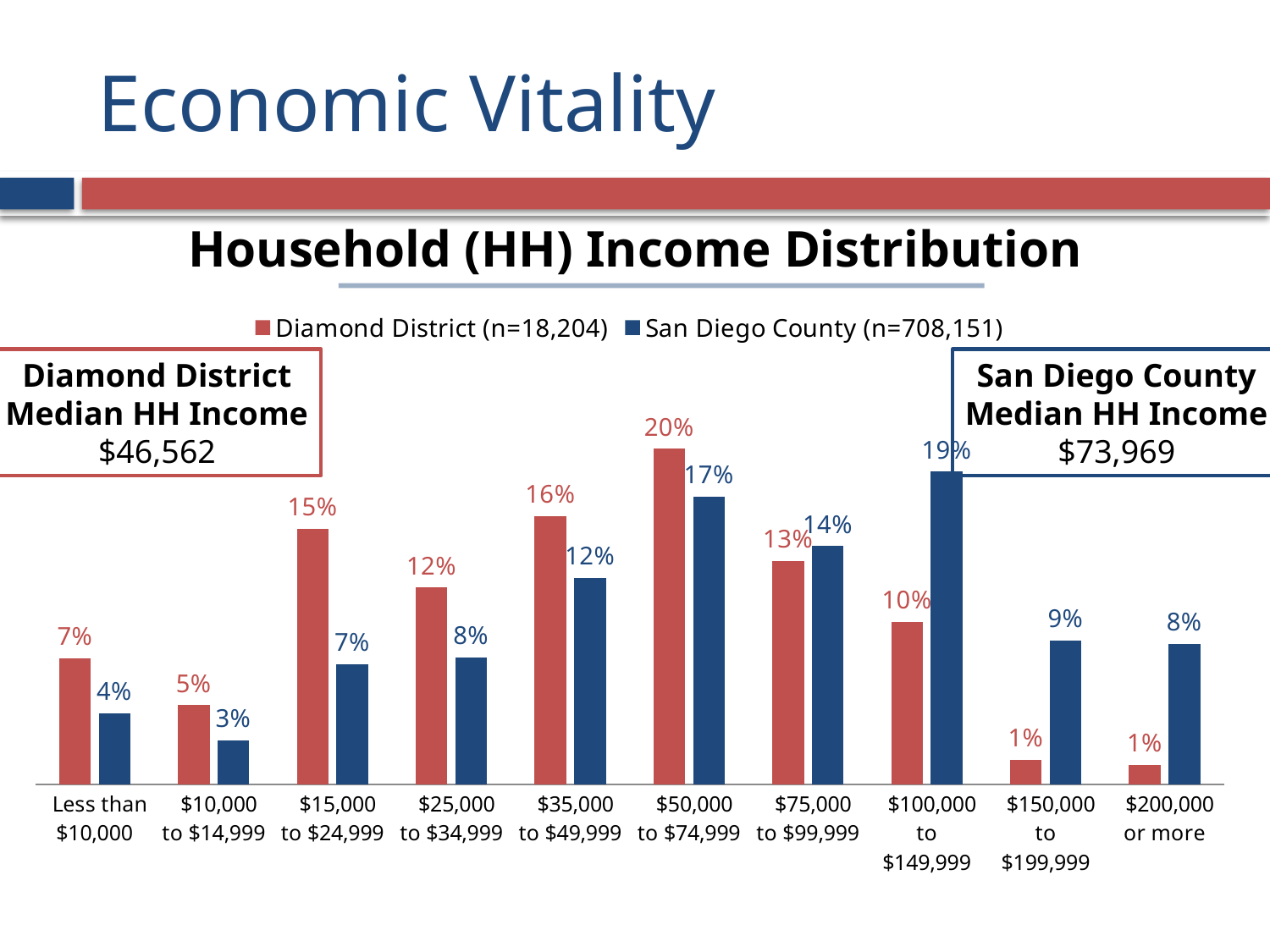
How many income brackets are shown on the x axis? 10 What is the Diamond District median household income shown on the slide? $46,562 What is the Diamond District value for the $50,000 to $74,999 income bracket? 20% What is the San Diego County value for the $200,000 or more income bracket? 8% How many series does the legend list? 2 Which income bracket has the lowest San Diego County value? $10,000 to $14,999 What kind of chart is shown on the slide? Bar chart What is the difference between the Diamond District and San Diego County values for the $15,000 to $24,999 bracket? 8% Which income bracket has the highest Diamond District value? $50,000 to $74,999 What is the sample size (n) for San Diego County in the legend? 708,151 What is the San Diego County value for the $100,000 to $149,999 income bracket? 19% Which is larger for the $150,000 to $199,999 bracket, the Diamond District value or the San Diego County value? San Diego County